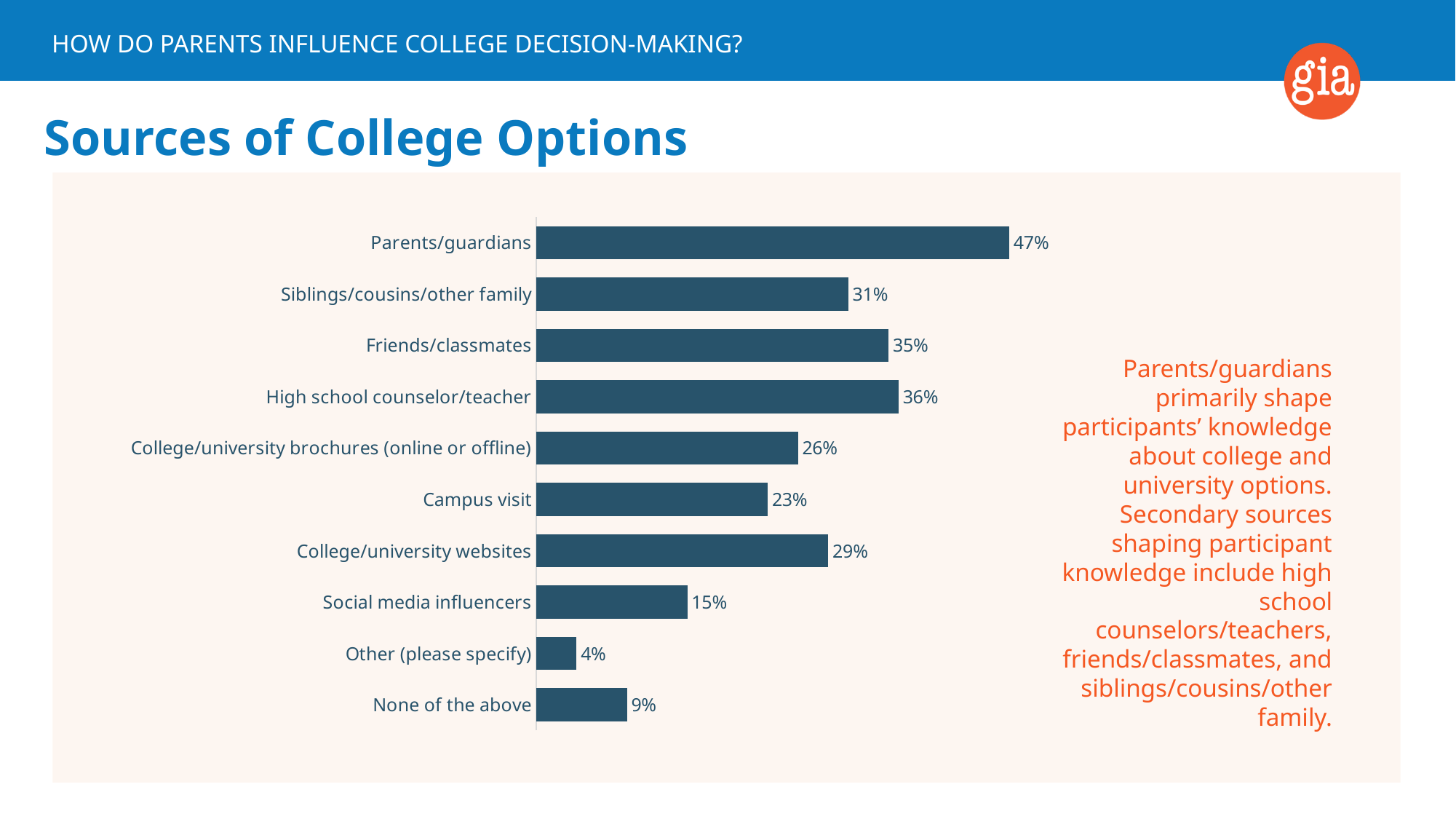
What is the difference between the values for College/university websites and College/university brochures (online or offline)? 3% Which is larger, the value for None of the above or the value for Other (please specify)? None of the above What is the value for Parents/guardians? 47% What is the difference between the values for Parents/guardians and Siblings/cousins/other family? 16% How many categories are shown in the chart? 10 What is the value for Campus visit? 23% What kind of chart is shown on the slide? Bar chart Which category has the highest value? Parents/guardians What is the value for Social media influencers? 15% Which category has the lowest value? Other (please specify) What is the title of the chart? Sources of College Options Which is larger, the value for High school counselor/teacher or the value for Friends/classmates? High school counselor/teacher